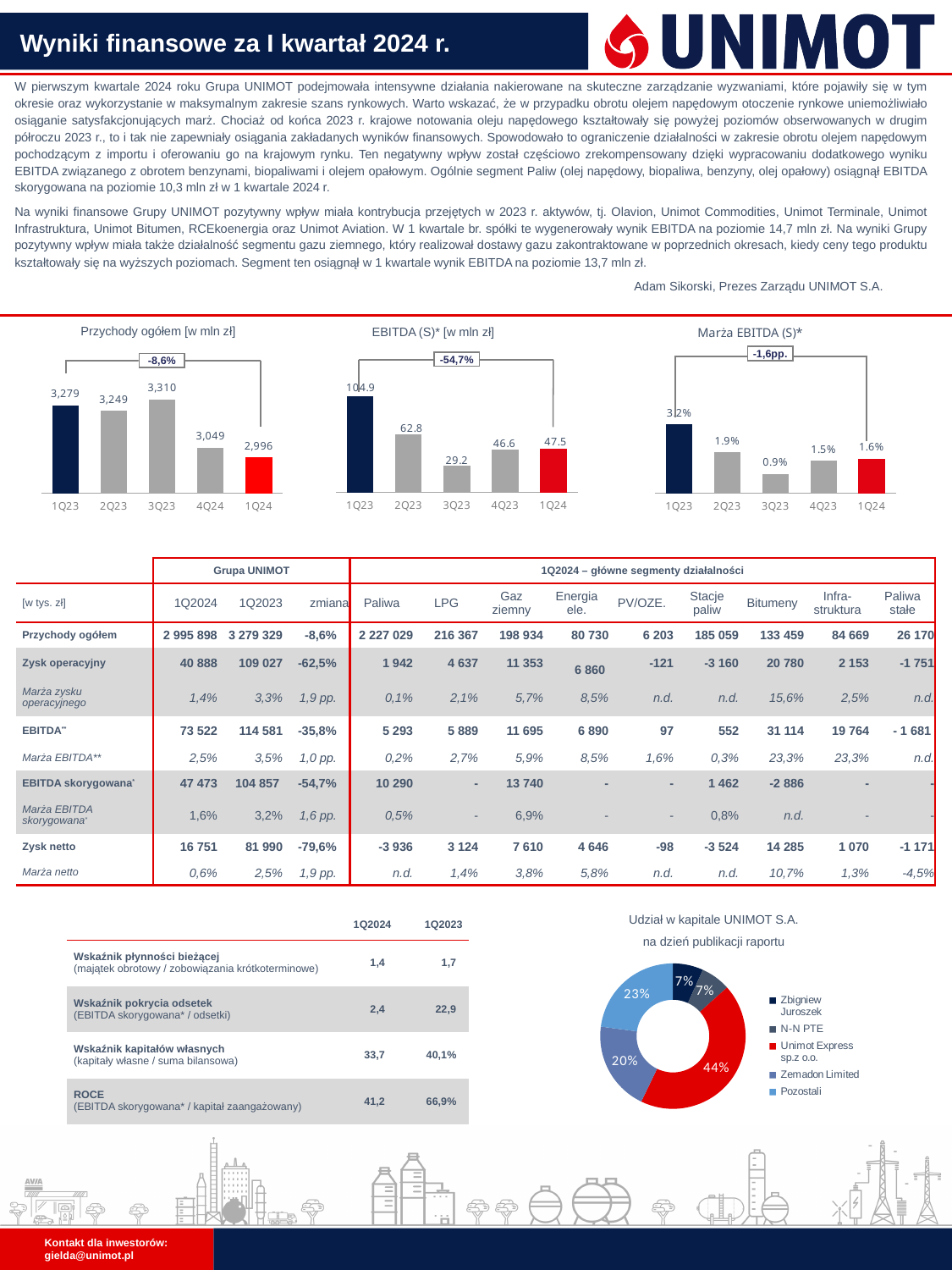
How many bars are in the chart titled 'Marża EBITDA (S)*'? 5 In the chart titled 'Marża EBITDA (S)*', what is the value for 1Q24? 1.6% How many entries does the legend of the chart titled 'Udział w kapitale UNIMOT S.A.' list? 5 In the chart titled 'EBITDA (S)* [w mln zł]', is the value for 2Q23 or 4Q23 larger? 2Q23 In the chart titled 'Przychody ogółem [w mln zł]', what is the value for 3Q23? 3,310 In the chart titled 'Marża EBITDA (S)*', which quarter has the highest value? 1Q23 In the chart titled 'Przychody ogółem [w mln zł]', which quarter has the lowest value? 1Q24 In the chart titled 'EBITDA (S)* [w mln zł]', what percentage change is shown between 1Q23 and 1Q24? -54,7% In the donut chart titled 'Udział w kapitale UNIMOT S.A.', what share does Unimot Express sp.z o.o. hold? 44% In the chart titled 'EBITDA (S)* [w mln zł]', which quarter has the lowest value? 3Q23 In the chart titled 'Przychody ogółem [w mln zł]', what is the difference between the 1Q23 and 1Q24 values? 283 In the chart titled 'EBITDA (S)* [w mln zł]', what is the value for 1Q23? 104.9